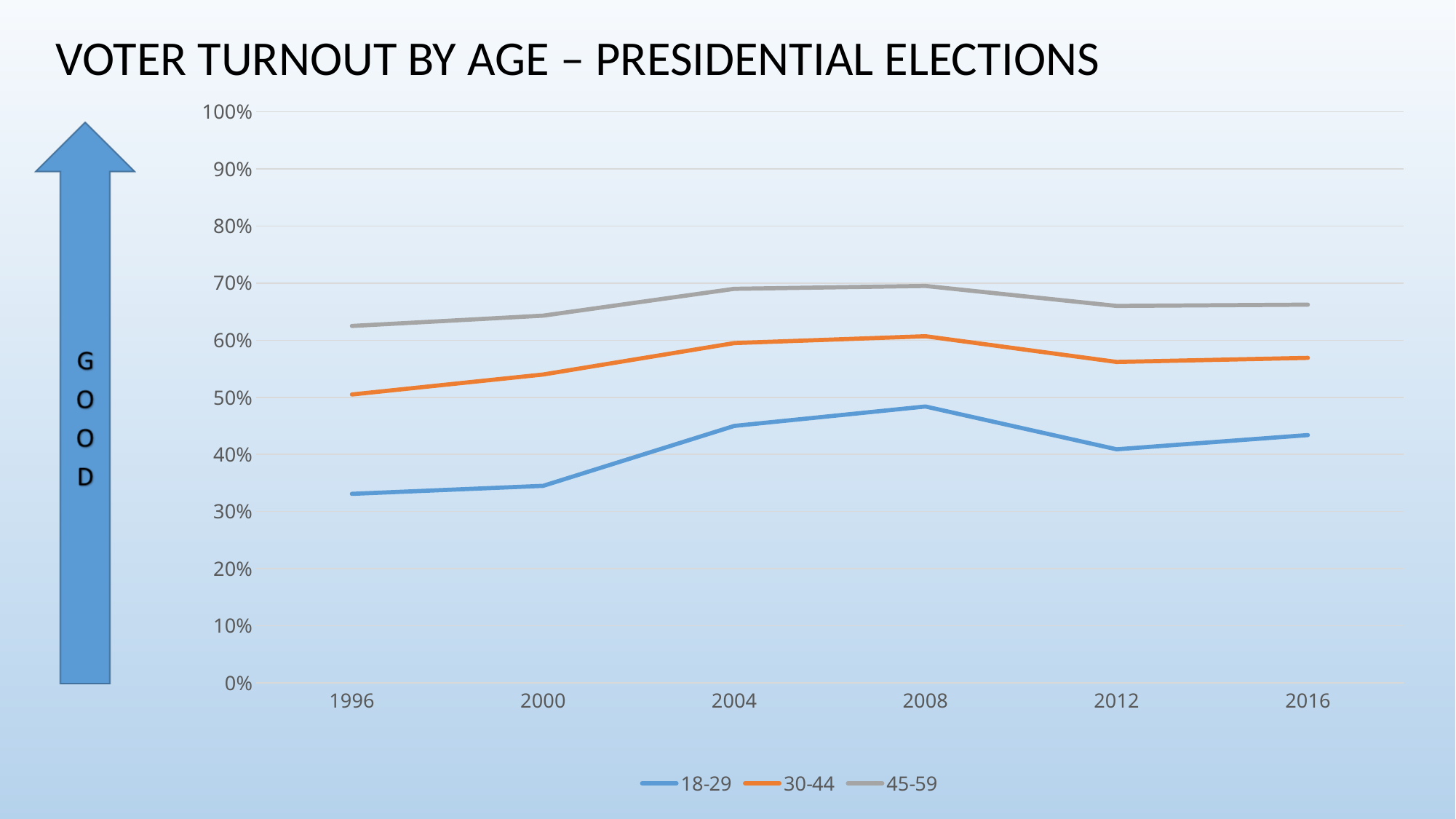
Which age group has the highest turnout across all years shown? 45-59 Is the value for the 30-44 series in 2012 greater or less than 60%? less What kind of chart is shown on the slide? line chart Is the value for the 45-59 series in 1996 greater or less than 60%? greater For the 18-29 series, is the value in 2004 or in 2012 larger? 2004 How many series does the legend list? 3 What is the title of the chart? VOTER TURNOUT BY AGE – PRESIDENTIAL ELECTIONS How many election years are plotted on the x axis? 6 Is the value for the 18-29 series in 1996 greater or less than 40%? less In which year does the 18-29 series reach its highest value? 2008 Does the 18-29 series rise or fall from 1996 to 2008? rise In which year is the 30-44 series at its lowest value? 1996